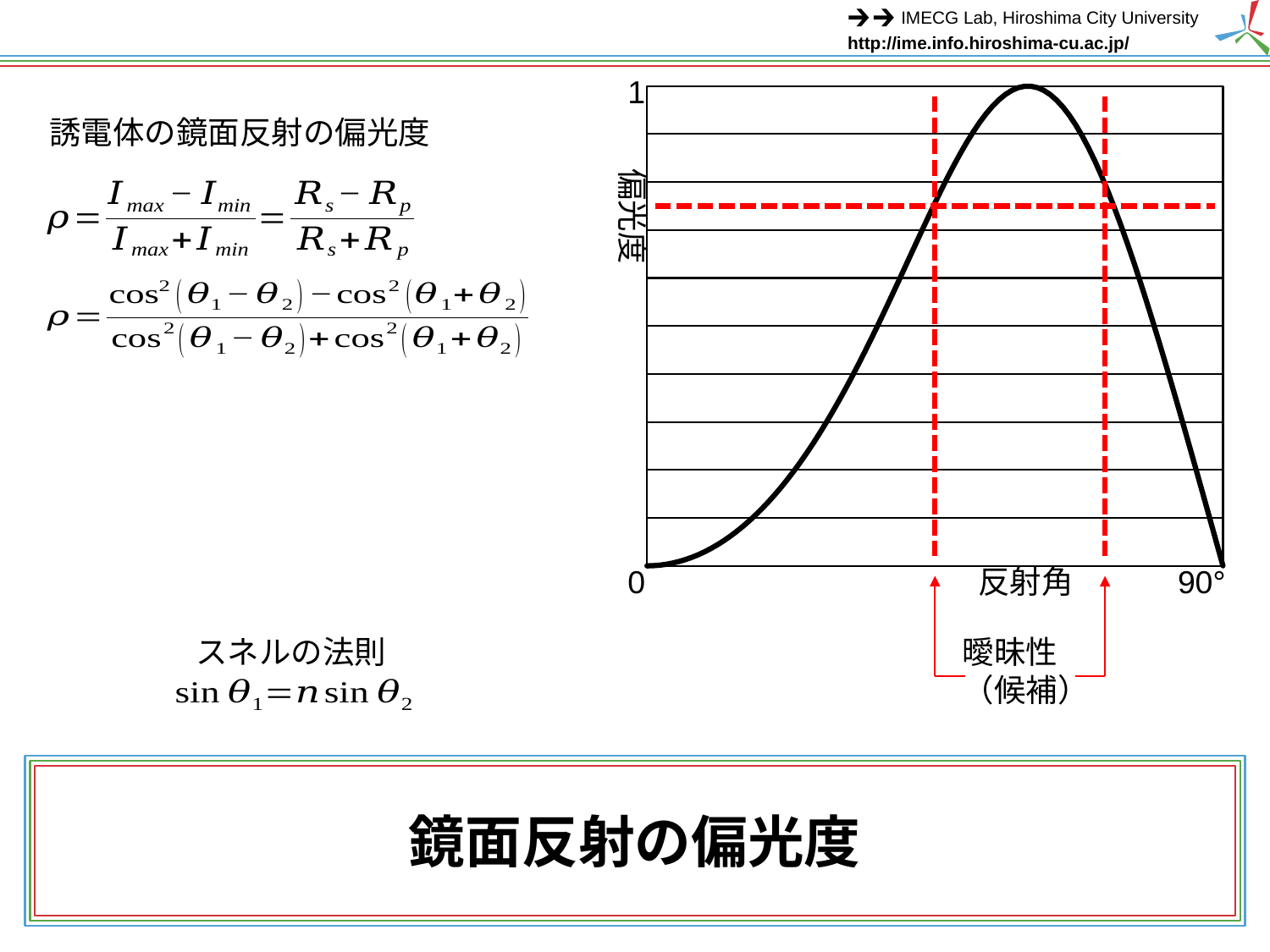
What is the label of the x axis of the chart? 反射角 What is the maximum value reached by the curve? 1 What is the value of the curve at a reflection angle of 0? 0 What kind of chart is shown on the right side of the slide? line chart What is the value of the curve at a reflection angle of 90°? 0 Does the curve rise or fall as the reflection angle increases from 0 toward its peak? rise How many red dashed vertical lines (candidate angles) are marked on the chart? 2 What is the largest value shown on the x axis of the chart? 90° What label is given to the two red dashed vertical lines below the chart? 曖昧性（候補） Does the curve rise or fall as the reflection angle increases from its peak toward 90°? fall What is the label of the y axis of the chart? 偏光度 What is the highest value shown on the y axis of the chart? 1